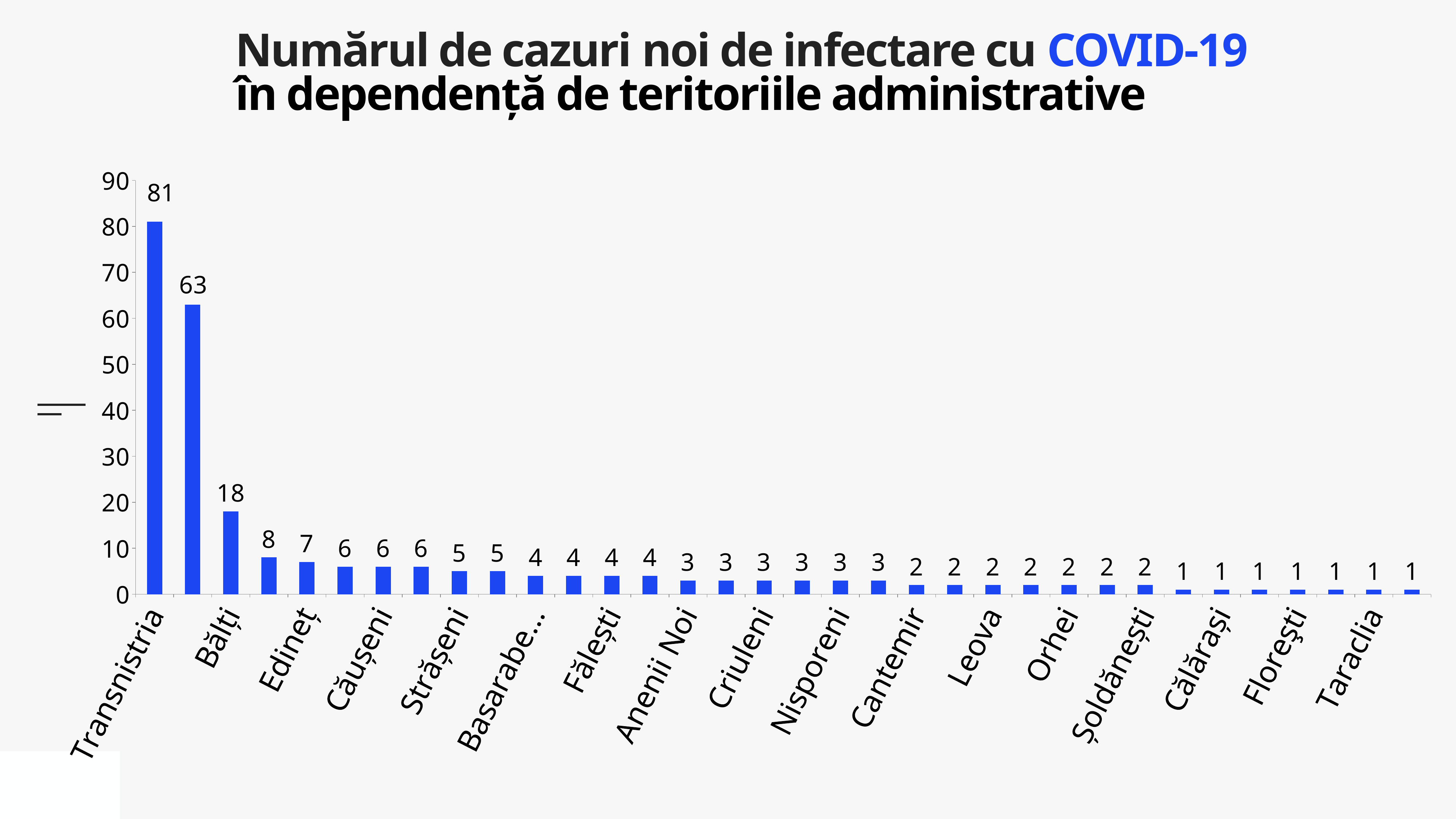
What is the value for Strășeni? 5 What is the value for Nisporeni? 3 Which territory has the highest number of new cases? Transnistria What is the value for Taraclia? 1 What is the value for Căușeni? 6 What is the value for Leova? 2 Do the values rise or fall from left to right along the x axis? fall What is the difference between the values for Transnistria and Leova? 79 What kind of chart is shown on the slide? bar chart What is the value for Transnistria? 81 What is the value for Fălești? 4 Which is larger, the value for Transnistria or the value for Căușeni? Transnistria